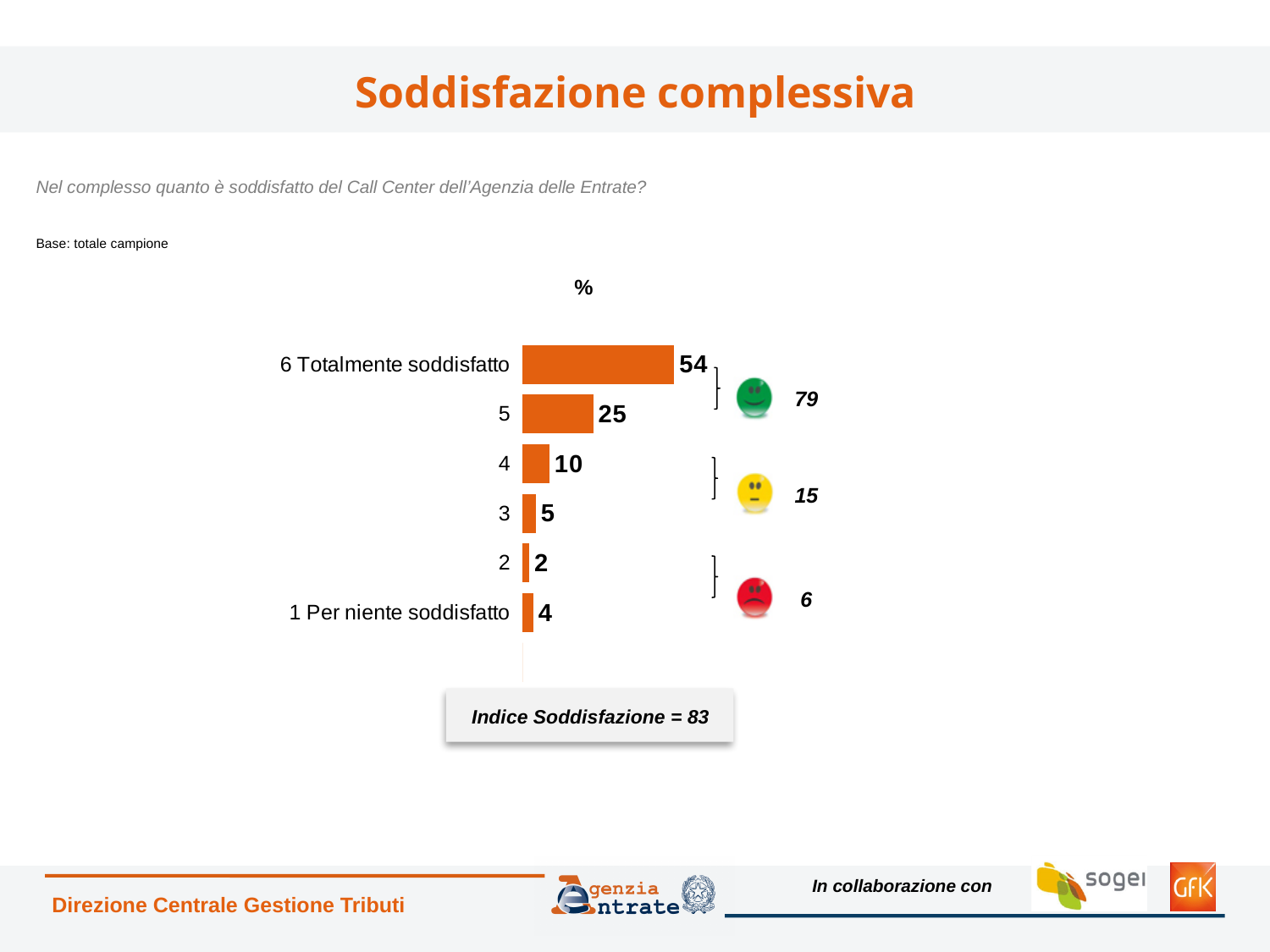
Which is larger, the value for category 3 or the value for "1 Per niente soddisfatto"? 3 What is the combined value shown next to the green smiley face? 79 What is the value for category 5? 25 What is the value for "6 Totalmente soddisfatto"? 54 What is the value of the "Indice Soddisfazione" shown below the chart? 83 What is the value for category 4? 10 What is the value for "1 Per niente soddisfatto"? 4 Which category has the highest value? 6 Totalmente soddisfatto What is the difference between the values for "6 Totalmente soddisfatto" and category 5? 29 What kind of chart is shown on the slide? bar chart Which category has the lowest value? 2 How many categories are shown in the chart? 6